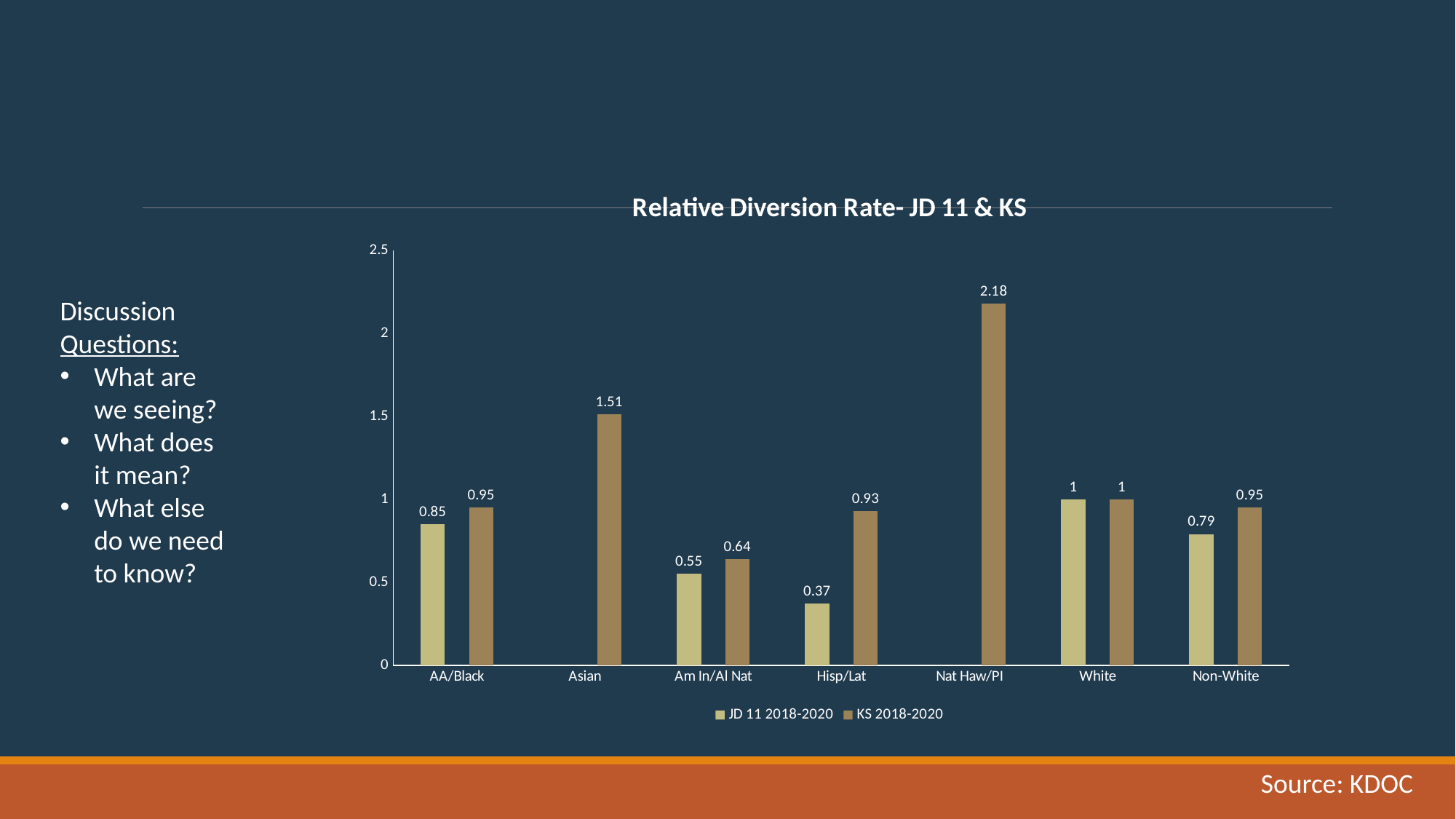
How many categories are shown on the x axis? 7 Which is larger for Am In/Al Nat: the JD 11 2018-2020 value or the KS 2018-2020 value? KS 2018-2020 What is the difference between the KS 2018-2020 and JD 11 2018-2020 values for Hisp/Lat? 0.56 What is the KS 2018-2020 value for Asian? 1.51 Is the KS 2018-2020 value for Nat Haw/PI greater or less than 2? greater Which category has the highest KS 2018-2020 value? Nat Haw/PI Which category has the lowest JD 11 2018-2020 value? Hisp/Lat What is the JD 11 2018-2020 value for Non-White? 0.79 What type of chart is shown on the slide? Bar chart What is the KS 2018-2020 value for Nat Haw/PI? 2.18 How many series does the legend list? 2 What is the JD 11 2018-2020 value for Hisp/Lat? 0.37